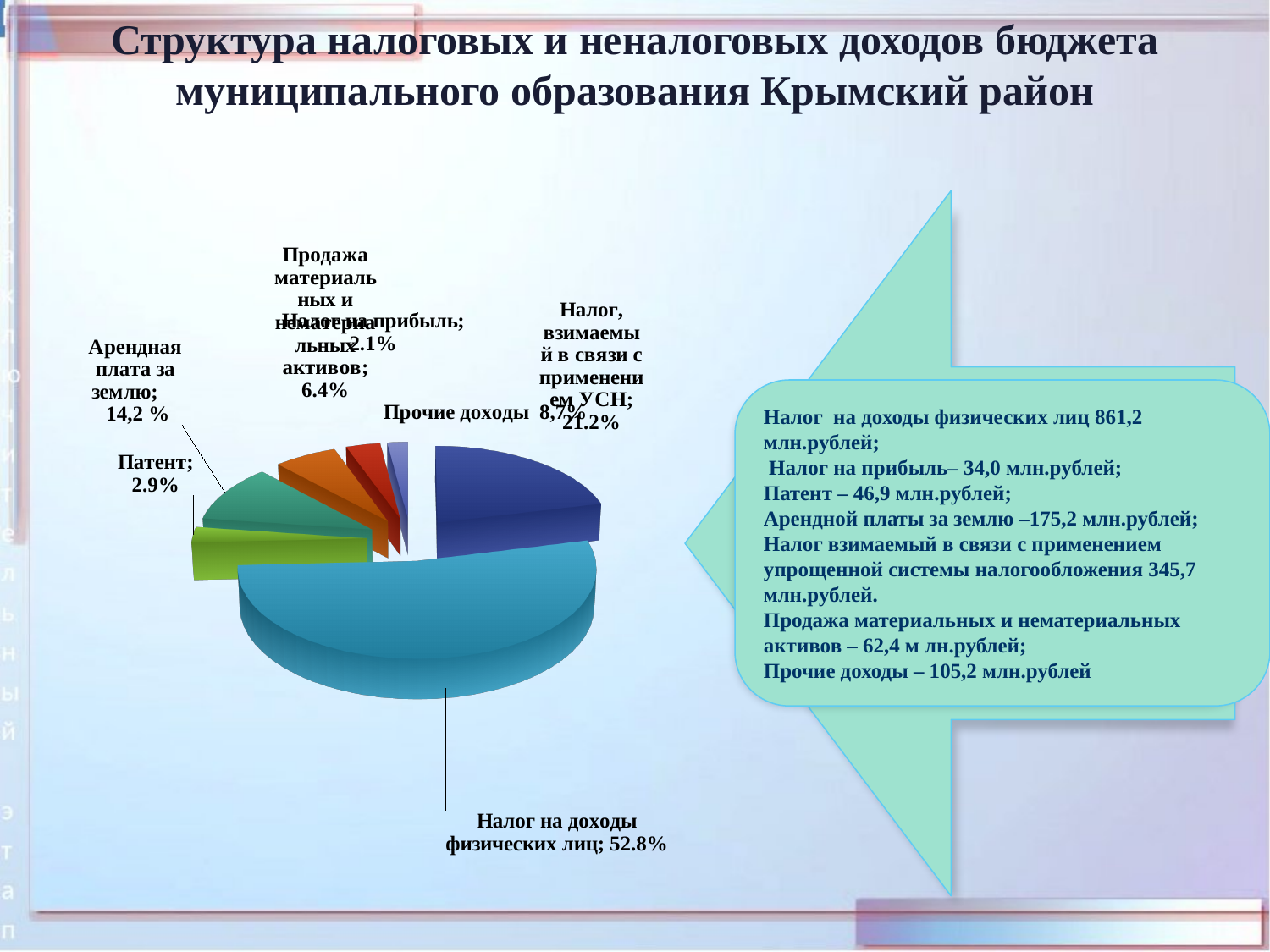
What share of the budget revenue is labelled for 'Налог на доходы физических лиц'? 52.8% What kind of chart is shown on the slide? pie chart What is the title of the slide containing the chart? Структура налоговых и неналоговых доходов бюджета муниципального образования Крымский район What percentage is shown for 'Арендная плата за землю'? 14,2 % What percentage is shown for 'Патент'? 2.9% Which category has the largest share of the pie? Налог на доходы физических лиц What percentage is shown for 'Продажа материальных и нематериальных активов'? 6.4% What percentage is shown for 'Налог, взимаемый в связи с применением УСН'? 21.2% Which is larger: the share for 'Арендная плата за землю' or the share for 'Налог, взимаемый в связи с применением УСН'? Налог, взимаемый в связи с применением УСН What percentage is shown for 'Налог на прибыль'? 2.1% By how many percentage points does the share of 'Налог на доходы физических лиц' exceed the share of 'Налог, взимаемый в связи с применением УСН'? 31.6 Which labelled category has the smallest share of the pie? Налог на прибыль